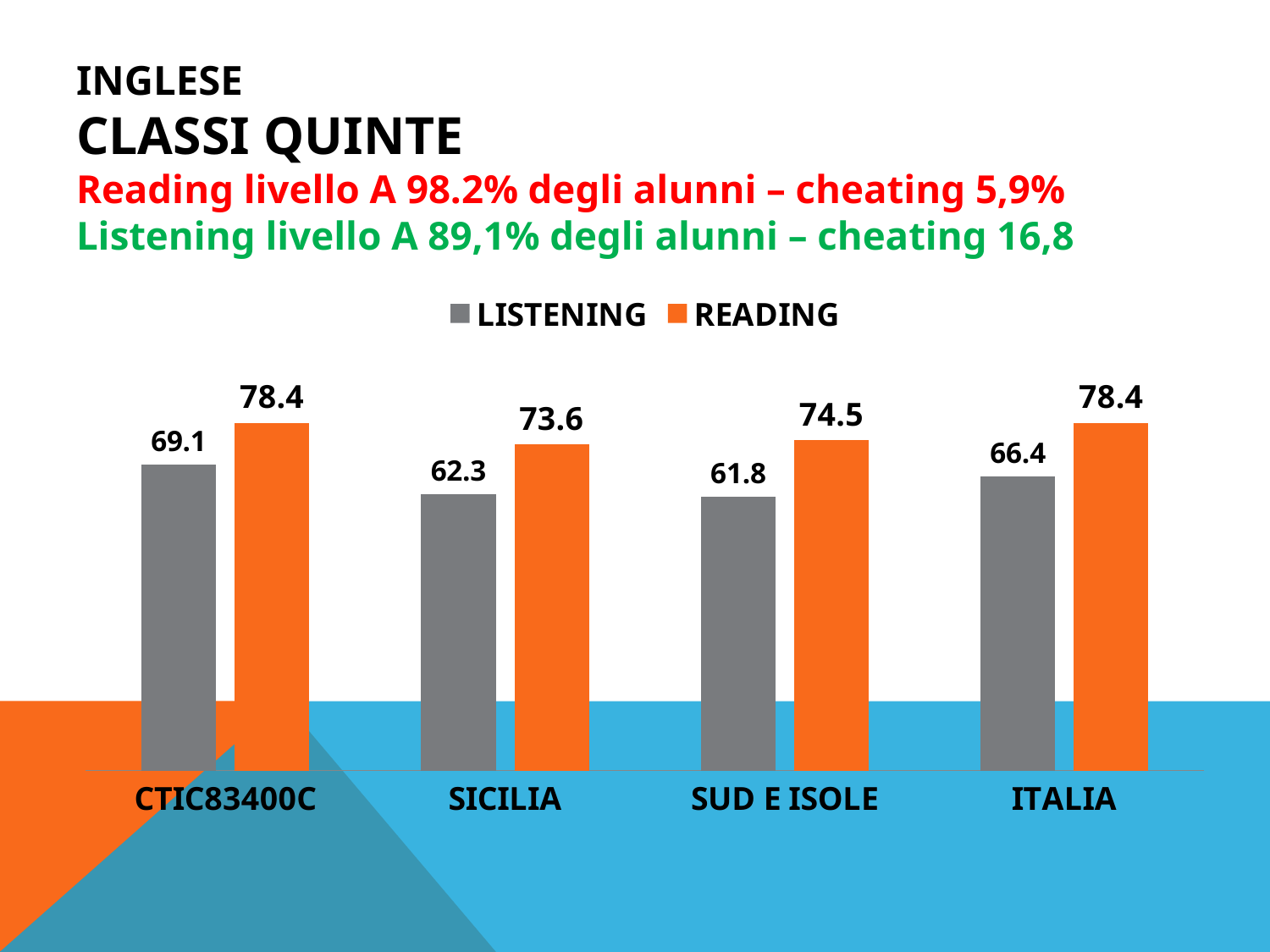
Which category has the highest LISTENING value? CTIC83400C What is the LISTENING value for ITALIA? 66.4 How many series does the legend list? 2 Which category has the lowest READING value? SICILIA What is the READING value for SICILIA? 73.6 Which category has the lowest LISTENING value? SUD E ISOLE What is the difference between the READING and LISTENING values for CTIC83400C? 9.3 How many categories are shown on the x axis of the chart? 4 What is the LISTENING value for CTIC83400C? 69.1 What is the difference between the LISTENING values for CTIC83400C and ITALIA? 2.7 What is the READING value for SUD E ISOLE? 74.5 Which is larger for SICILIA, the LISTENING value or the READING value? READING